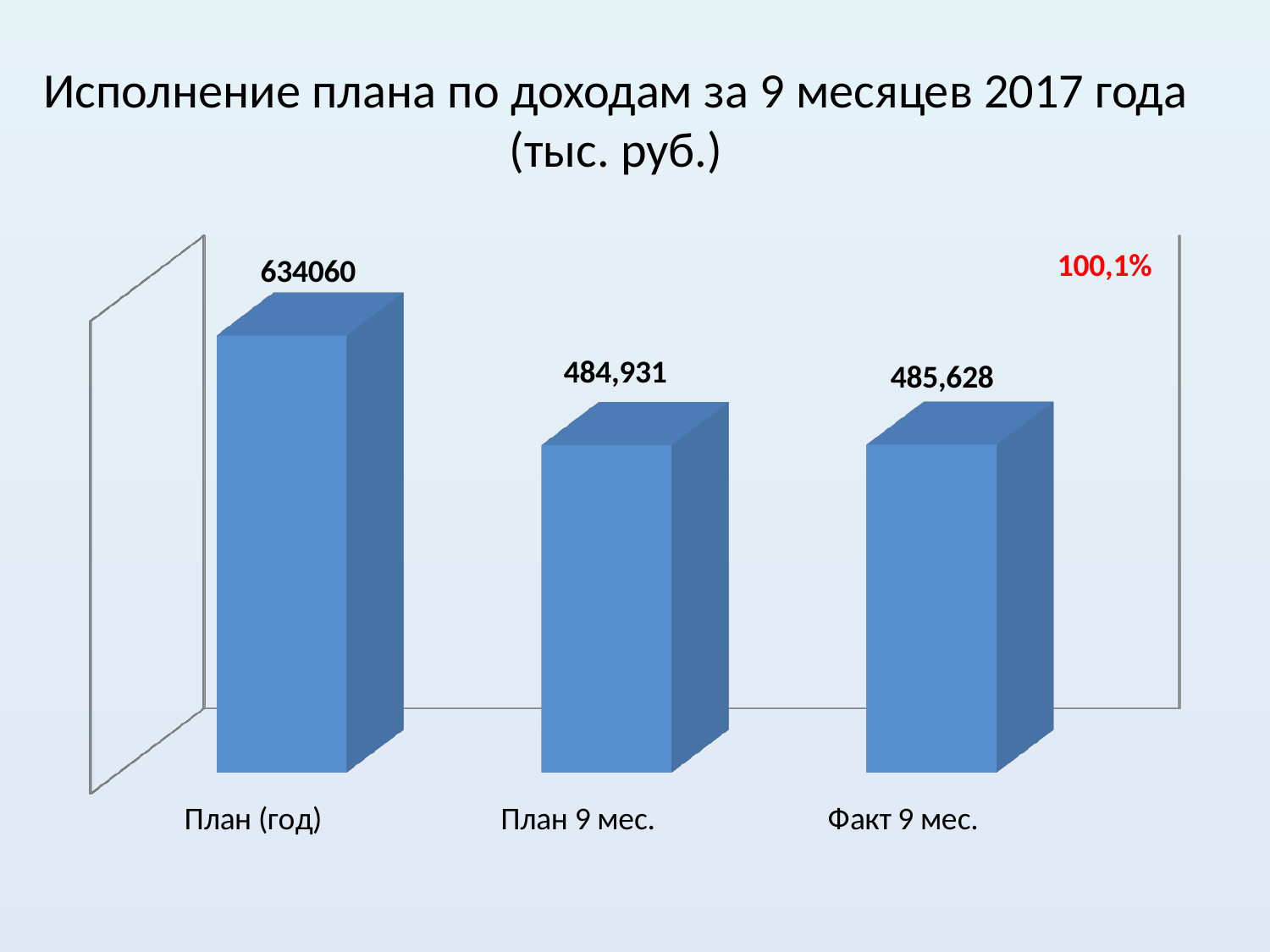
How many categories are shown in the chart? 3 What is the value for Факт 9 мес.? 485,628 What is the title of the chart? Исполнение плана по доходам за 9 месяцев 2017 года (тыс. руб.) What percentage is shown in red in the top right corner of the chart? 100,1% What kind of chart is shown on the slide? Bar chart Which is larger, the value for План 9 мес. or the value for Факт 9 мес.? Факт 9 мес. What is the value for План 9 мес.? 484,931 Which category has the highest value? План (год) Which category has the lowest value? План 9 мес. Which is larger, the value for План (год) or the value for Факт 9 мес.? План (год) What is the value for План (год)? 634060